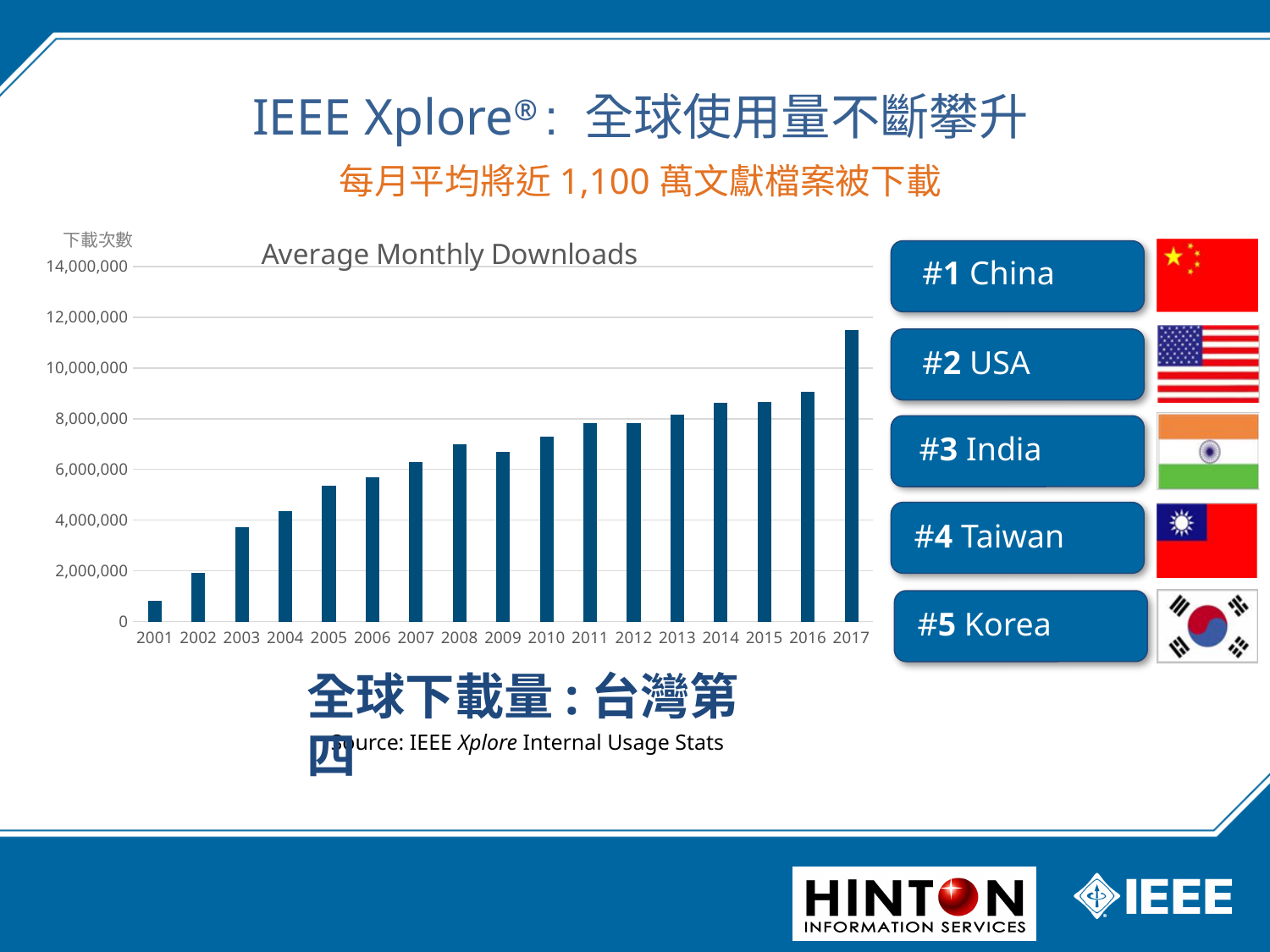
Which year has the highest average monthly downloads? 2017 Which year has the larger value, 2016 or 2017? 2017 Is the value for 2017 greater or less than 10,000,000? greater Is the value for 2005 greater or less than 4,000,000? greater Is the value for 2016 greater or less than 8,000,000? greater What kind of chart is shown on the slide? bar chart How many years are plotted on the x axis of the chart? 17 Which year has the larger value, 2002 or 2003? 2003 Do the average monthly downloads generally rise or fall from 2001 to 2017? rise What is the title of the chart? Average Monthly Downloads Which year has the lowest average monthly downloads? 2001